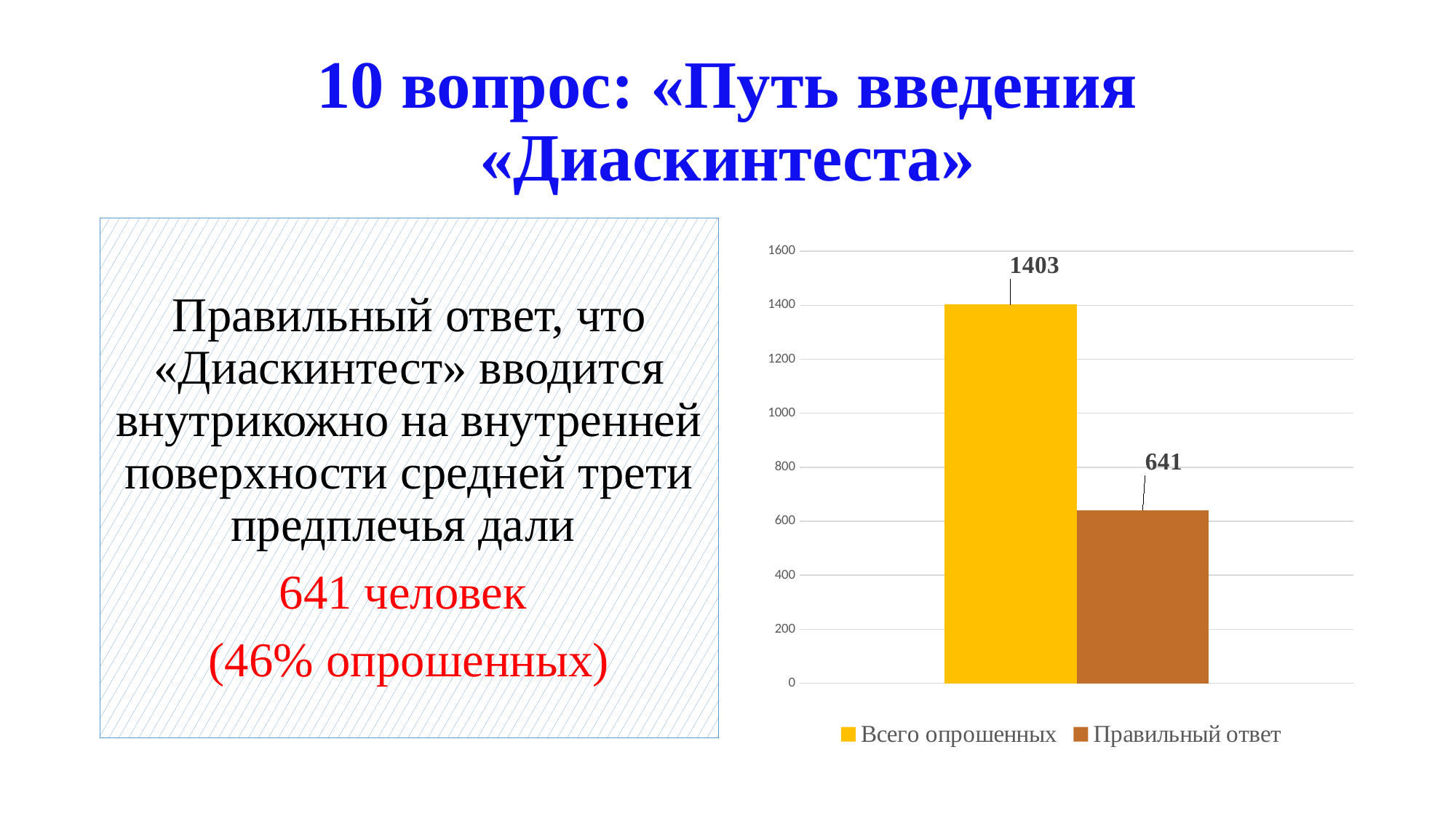
What colour is the bar for "Правильный ответ"? brown What is the highest value shown on the vertical axis? 1600 What is the value for "Всего опрошенных" in the chart? 1403 How many series does the legend list? 2 Is the value for "Всего опрошенных" greater or less than 1200? greater What kind of chart is shown on the slide? bar chart Which series has the higher value, "Всего опрошенных" or "Правильный ответ"? Всего опрошенных Is the value for "Правильный ответ" greater or less than 800? less How many bars are plotted in the chart? 2 Which series has the lowest value in the chart? Правильный ответ What is the value for "Правильный ответ" in the chart? 641 What is the difference between the values for "Всего опрошенных" and "Правильный ответ"? 762